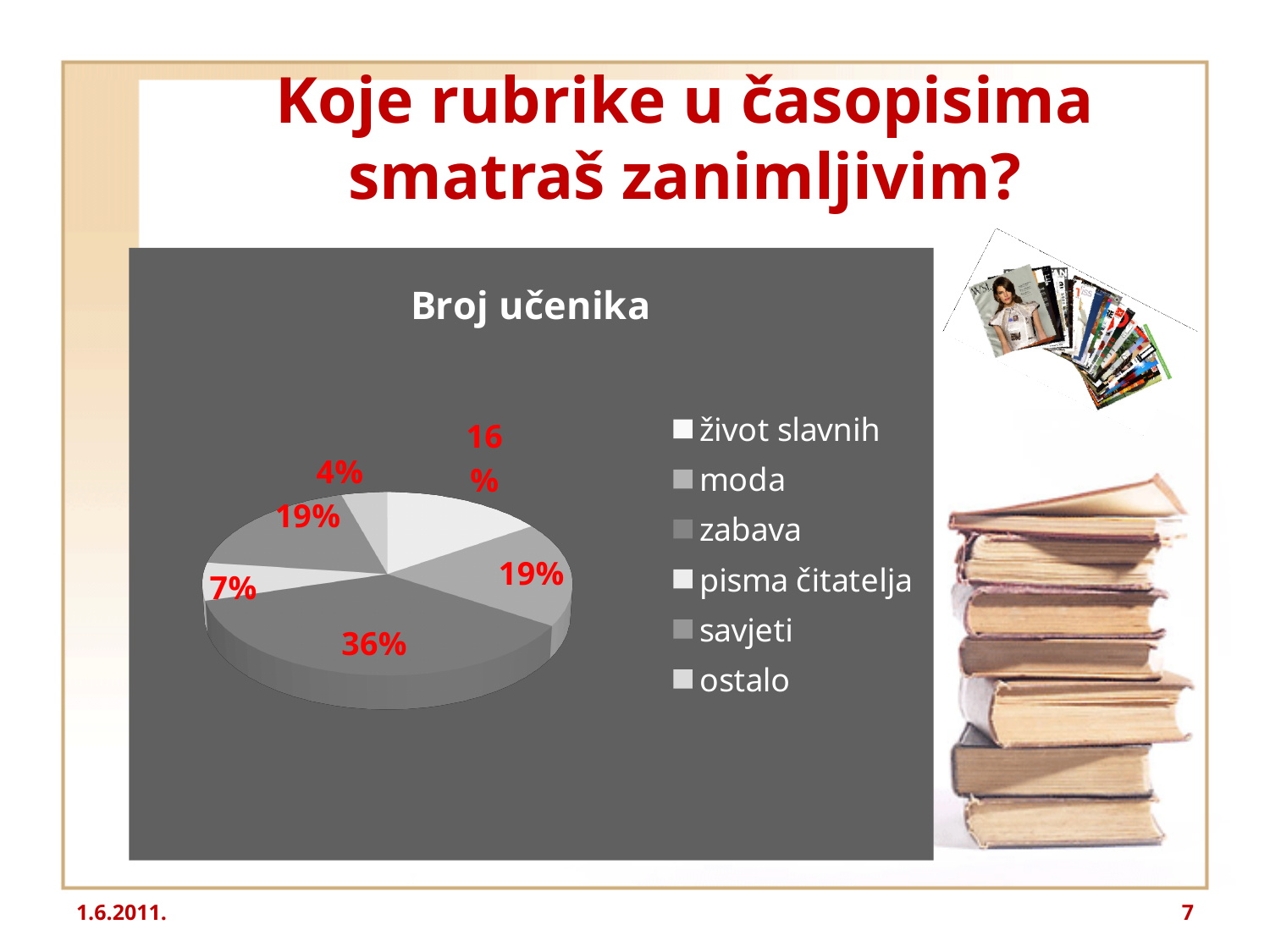
Which category has the smallest share of the pie? ostalo How many categories does the legend of the pie chart list? 6 What is the title of the chart? Broj učenika What type of chart is shown on the slide? pie chart Which category has the largest share of the pie? zabava What share of the pie does zabava have? 36% What share of the pie does pisma čitatelja have? 7% What is the difference in percentage points between the zabava slice and the pisma čitatelja slice? 29 What share of the pie does život slavnih have? 16% What is the last category listed in the legend? ostalo Which is larger, the share for zabava or the share for moda? zabava